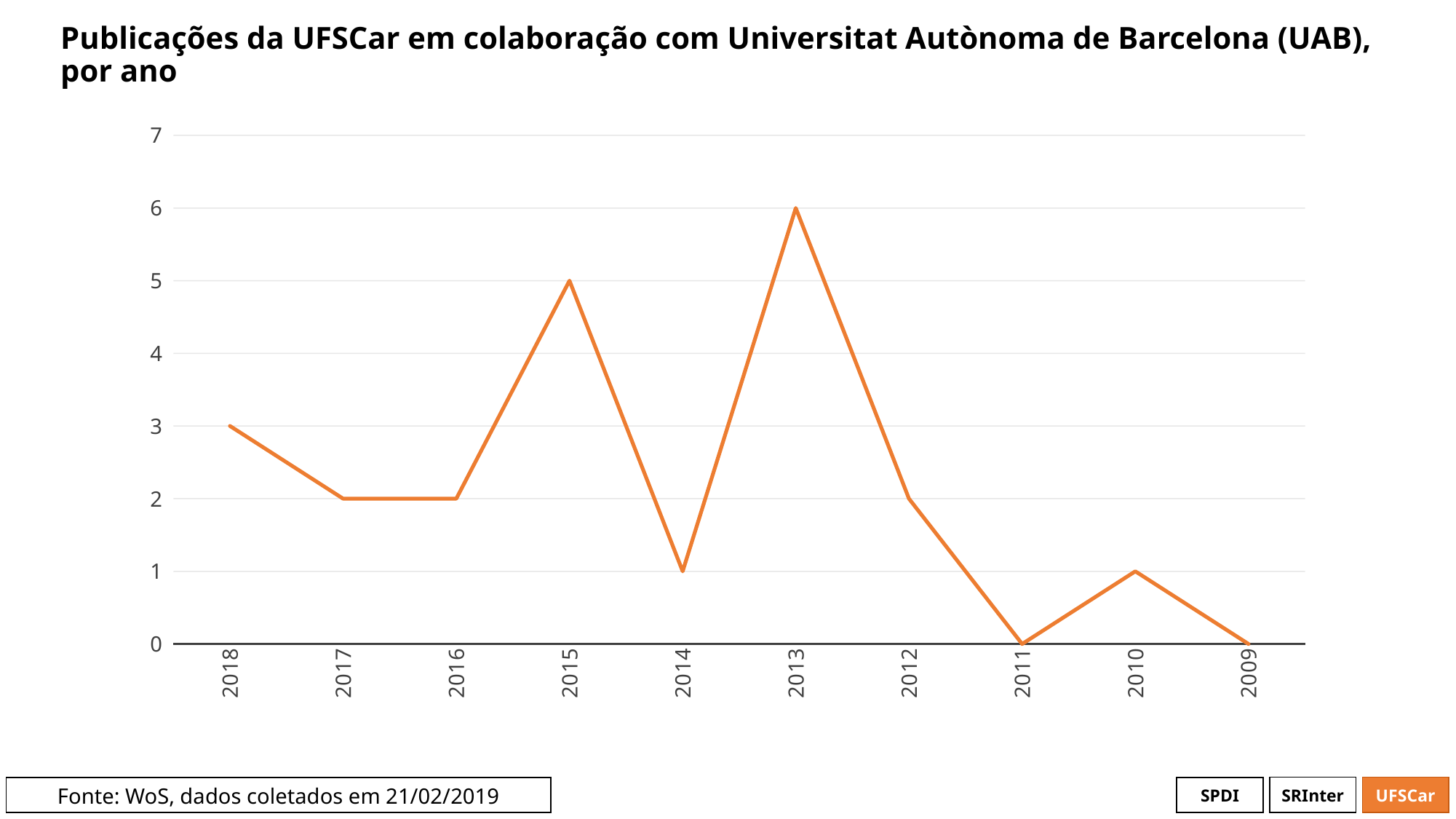
What is the value for 2015? 5 Which is larger, the value for 2018 or the value for 2017? 2018 What is the difference between the values for 2013 and 2015? 1 What is the value for 2014? 1 What is the value for 2018? 3 How many years are plotted on the x axis? 10 What is the value for 2011? 0 Is the value for 2015 greater or less than 4? greater What is the value for 2013? 6 What kind of chart is shown on the slide? line chart Which year has the highest number of publications? 2013 What is the source of the data cited on the slide? WoS, dados coletados em 21/02/2019